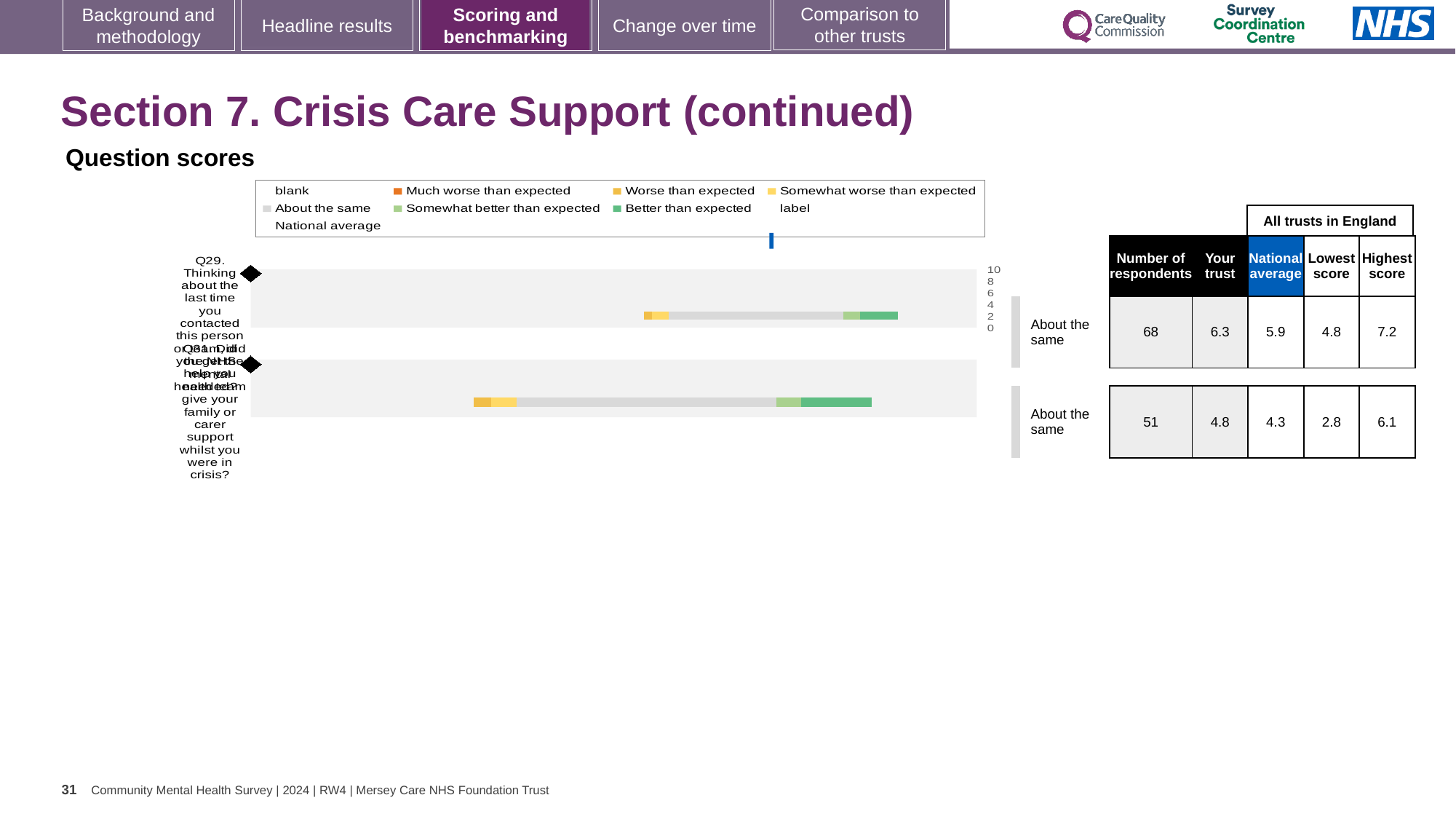
What is the 'Your trust' score for Q29 in the Question scores chart? 6.3 What is the highest score among all trusts in England for Q29? 7.2 What benchmark category is shown for both Q29 and Q31 in the Question scores chart? About the same Which question has the higher 'Your trust' score, Q29 or Q31? Q29 What kind of chart is shown under 'Question scores'? bar chart What is the lowest score among all trusts in England for Q31? 2.8 How many questions (bars) are plotted in the Question scores chart? 2 What is the difference between the highest and lowest scores for Q29? 2.4 Is the 'Your trust' score for Q31 greater or less than 6? less How many respondents answered Q31 in the Question scores chart? 51 For Q29, which is larger: the 'Your trust' score or the national average? Your trust What is the national average for Q29 in the Question scores chart? 5.9